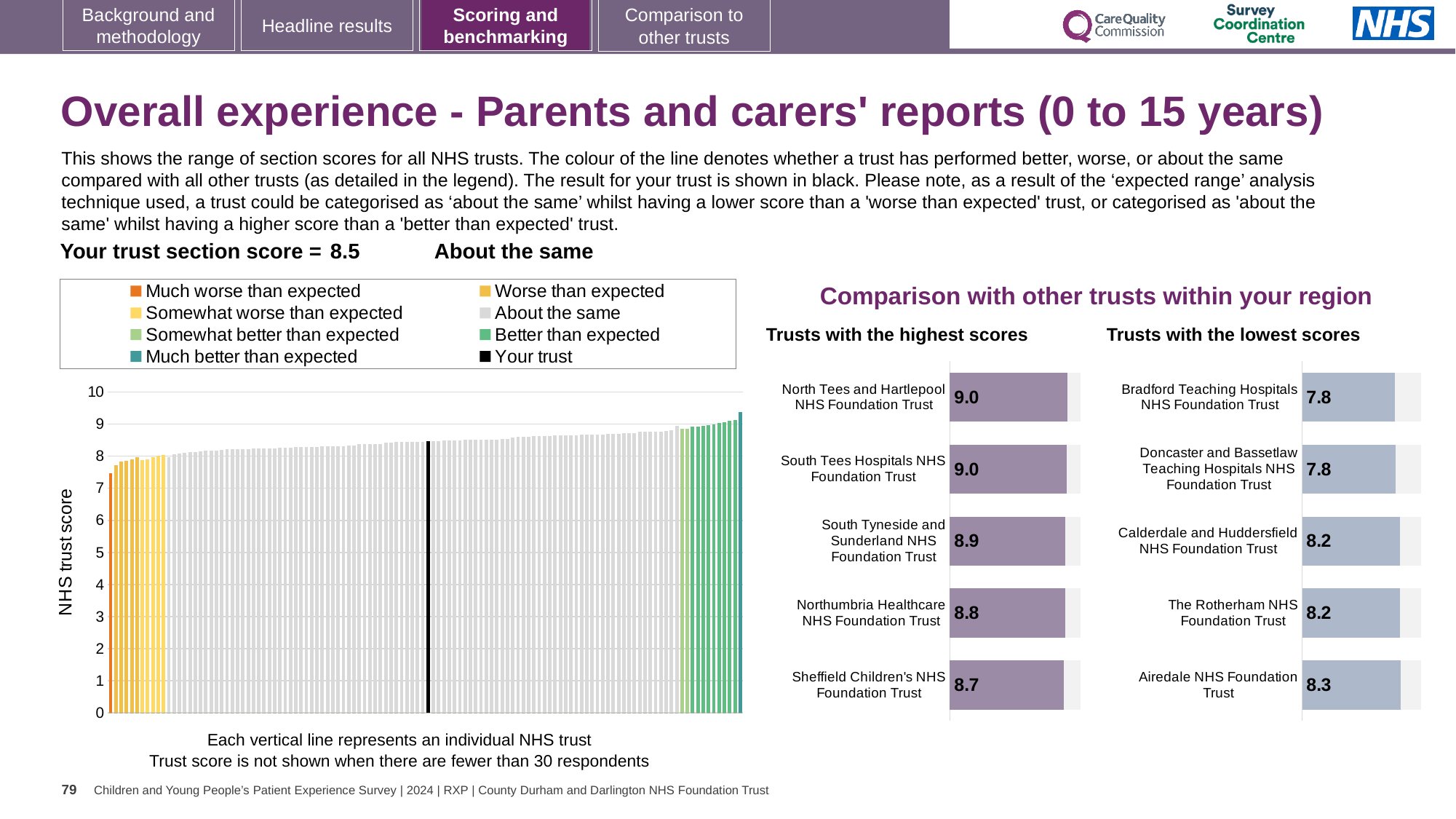
In the 'Trusts with the highest scores' chart, what is the score for North Tees and Hartlepool NHS Foundation Trust? 9.0 How many trusts are shown in the 'Trusts with the highest scores' chart? 5 In the 'Trusts with the lowest scores' chart, which trust has the highest score? Airedale NHS Foundation Trust In the 'Trusts with the lowest scores' chart, what is the difference between the scores of Airedale NHS Foundation Trust and Bradford Teaching Hospitals NHS Foundation Trust? 0.5 In the 'Trusts with the highest scores' chart, what is the difference between the scores of Northumbria Healthcare NHS Foundation Trust and Sheffield Children's NHS Foundation Trust? 0.1 In the 'Trusts with the highest scores' chart, which trust has the lowest score? Sheffield Children's NHS Foundation Trust In the 'Trusts with the lowest scores' chart, which has the larger score: Calderdale and Huddersfield NHS Foundation Trust or Airedale NHS Foundation Trust? Airedale NHS Foundation Trust What kind of chart is the large chart on the left showing NHS trust scores? Bar chart How many entries does the legend above the large chart on the left list? 8 In the 'Trusts with the highest scores' chart, what is the score for Sheffield Children's NHS Foundation Trust? 8.7 In the 'Trusts with the lowest scores' chart, what is the score for Airedale NHS Foundation Trust? 8.3 In the large chart on the left, do the trust scores rise or fall from left to right? Rise